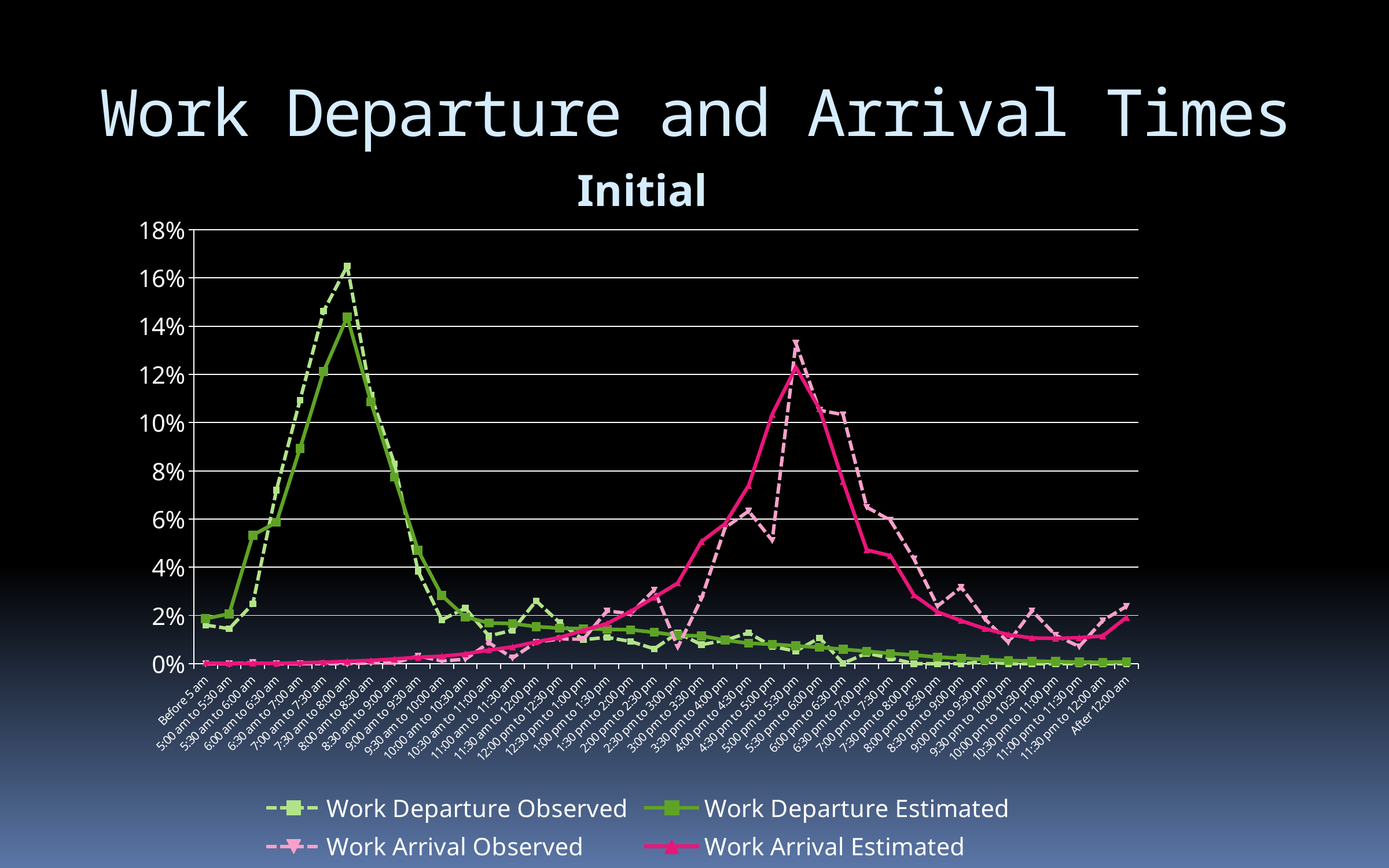
How many time categories are plotted along the x axis? 40 How many series does the legend list? 4 Is the value for Work Arrival Estimated at 5:00 pm to 5:30 pm greater or less than 10%? greater In which time period does Work Arrival Observed reach its highest value? 5:00 pm to 5:30 pm What kind of chart is shown on the slide? line chart At 6:00 am to 6:30 am, which is larger: Work Departure Observed or Work Departure Estimated? Work Departure Observed Is the value for Work Departure Observed at 7:30 am to 8:00 am greater or less than 14%? greater Does Work Arrival Estimated rise or fall from 2:00 pm to 2:30 pm through 5:00 pm to 5:30 pm? rise At 7:30 am to 8:00 am, which is larger: Work Departure Observed or Work Departure Estimated? Work Departure Observed Is the value for Work Departure Estimated at 6:00 am to 6:30 am greater or less than 4%? greater In which time period does Work Departure Observed reach its highest value? 7:30 am to 8:00 am What is the title of the chart? Initial